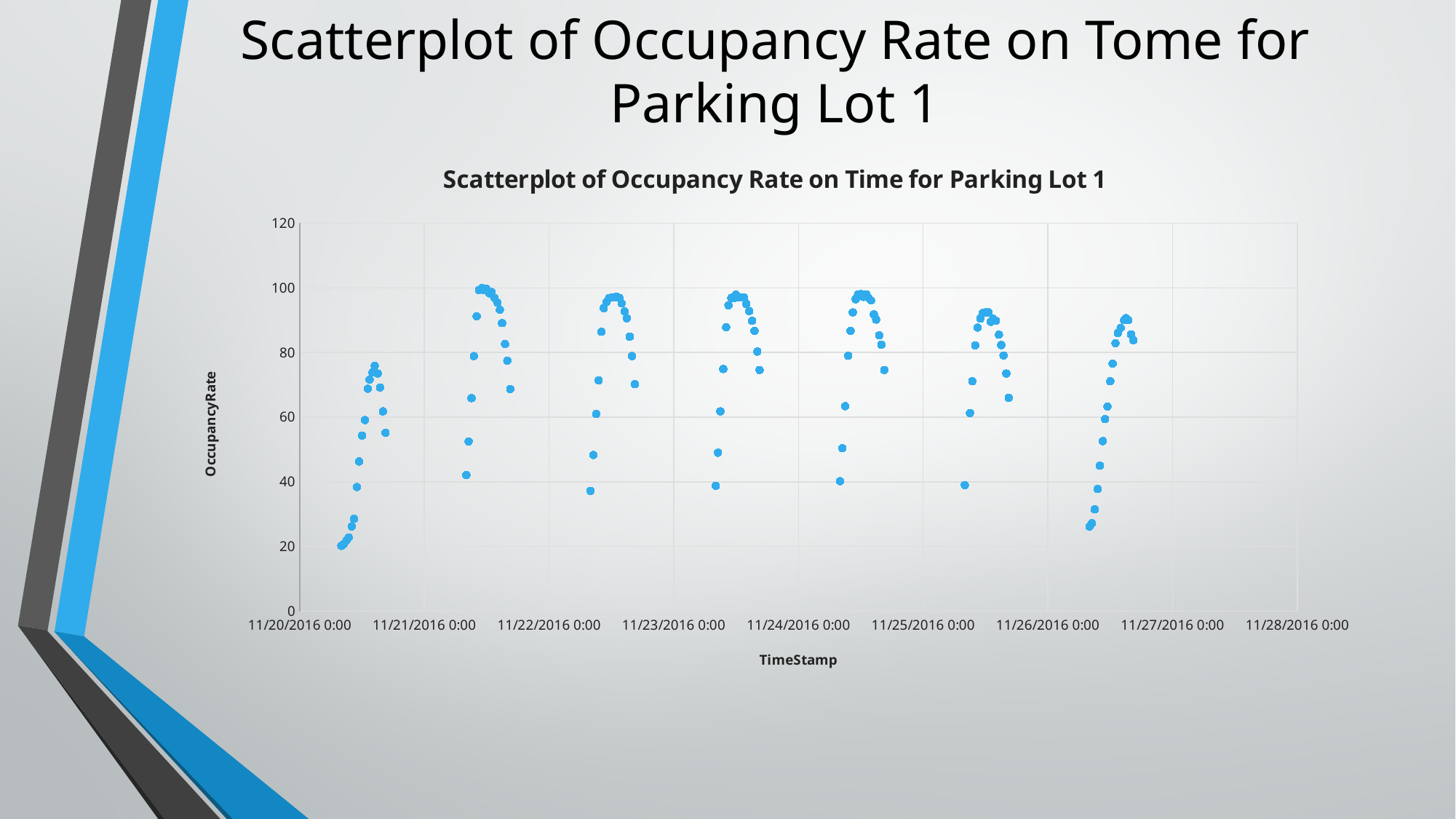
Is the lowest occupancy rate on 11/20/2016 greater or less than 40? less Is the peak occupancy rate on 11/26/2016 greater or less than 100? less Is the peak occupancy rate on 11/21/2016 greater or less than 80? greater Which day's cluster reaches the highest occupancy rate? 11/21/2016 What is the chart's title? Scatterplot of Occupancy Rate on Time for Parking Lot 1 What is the maximum value shown on the vertical axis? 120 What kind of chart is shown on the slide? Scatter plot How many daily clusters of points are plotted on the chart? 7 Which day has the higher peak occupancy rate, 11/20/2016 or 11/22/2016? 11/22/2016 Within each day's cluster, does the occupancy rate rise or fall at the start of the day? rise Which day's cluster contains the lowest occupancy rate on the chart? 11/20/2016 What is the label of the vertical axis? OccupancyRate